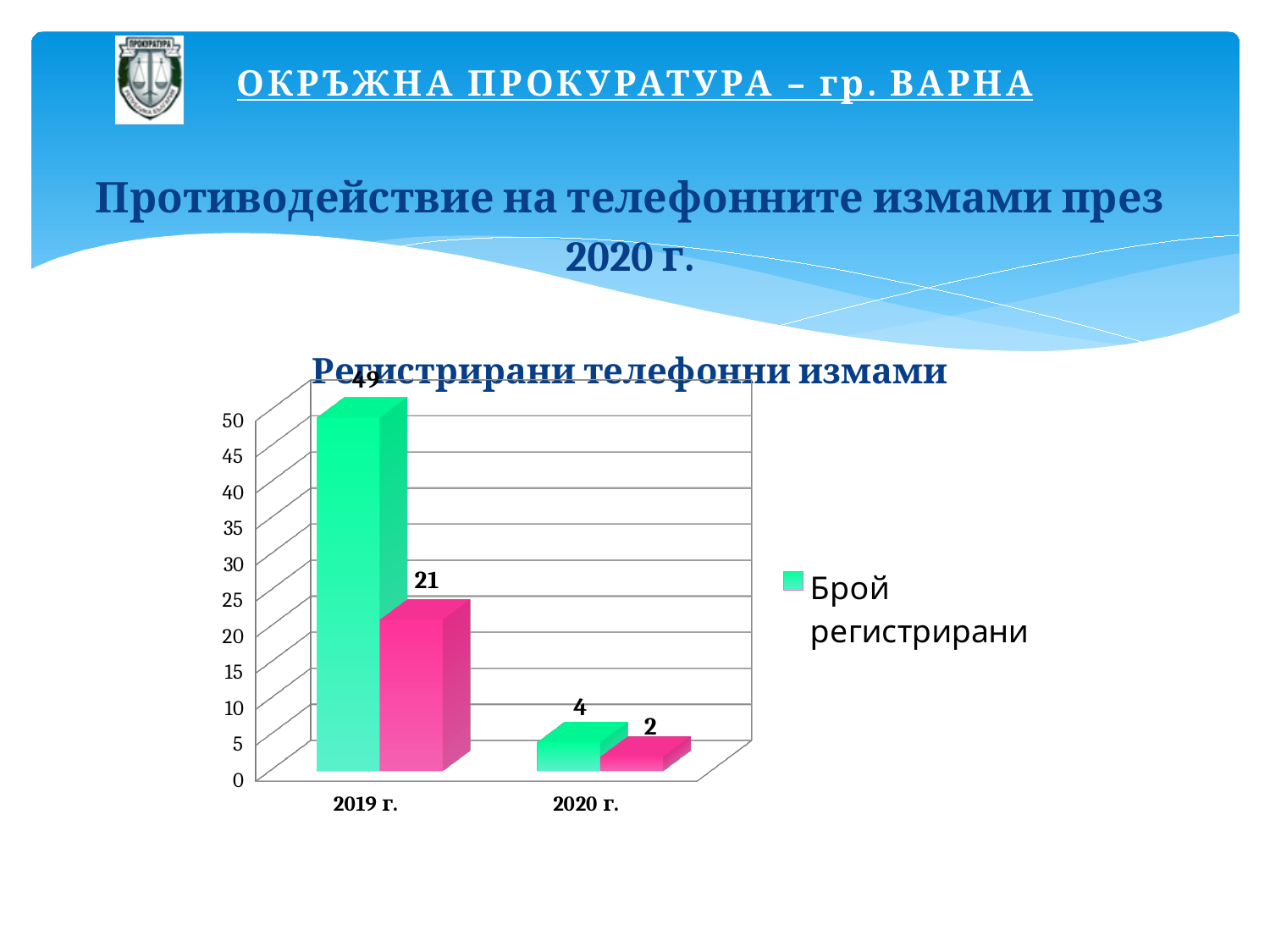
What kind of chart is shown on the slide? Bar chart Which year has the lowest value for 'Брой регистрирани'? 2020 г. Which year has the highest value for 'Брой регистрирани'? 2019 г. What is the title of the chart? Регистрирани телефонни измами What is the difference between the 'Брой регистрирани' values for 2019 г. and 2020 г.? 45 What is the value of the 'Брой регистрирани' series for 2019 г.? 49 Which is larger: the 'Брой регистрирани' value for 2019 г. or for 2020 г.? 2019 г. What is the value of the pink bar for 2020 г.? 2 How many entries does the legend list? 1 What is the value of the 'Брой регистрирани' series for 2020 г.? 4 How many year categories are shown on the x axis? 2 What is the value of the pink bar for 2019 г.? 21